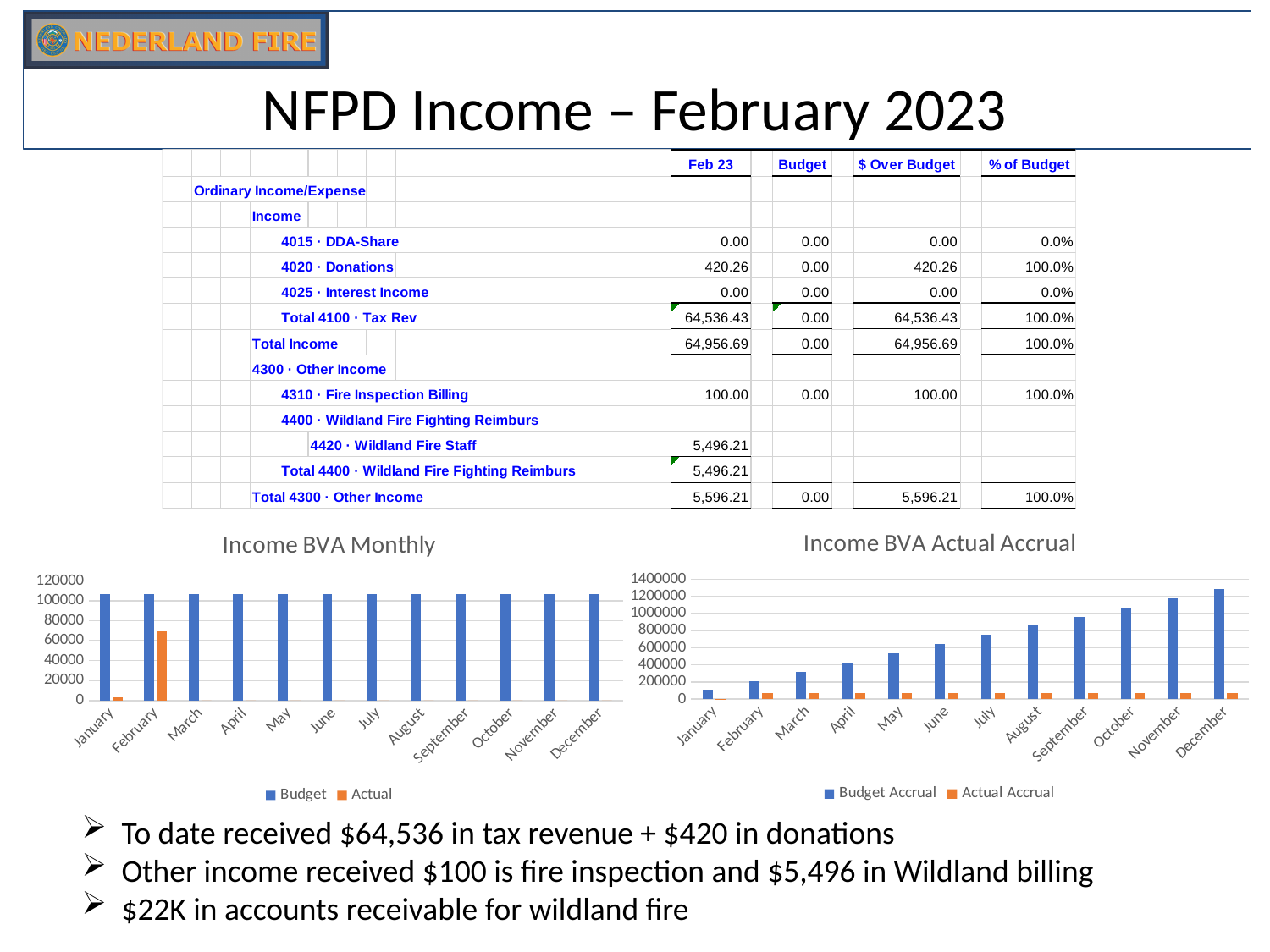
In the 'Income BVA Monthly' chart, which is larger for February, Budget or Actual? Budget In the 'Income BVA Actual Accrual' chart, which month has the highest Budget Accrual value? December In the 'Income BVA Actual Accrual' chart, do the Budget Accrual values rise or fall from January to December? rise How many months are shown on the x axis of the 'Income BVA Actual Accrual' chart? 12 How many series does the legend of the 'Income BVA Monthly' chart list? 2 In the 'Income BVA Actual Accrual' chart, is the Budget Accrual value for December greater or less than 1200000? greater What are the two legend entries of the 'Income BVA Actual Accrual' chart? Budget Accrual and Actual Accrual In the 'Income BVA Actual Accrual' chart, which month has the lowest Budget Accrual value? January What kind of chart is the 'Income BVA Monthly' chart? bar chart In the 'Income BVA Monthly' chart, is the Actual value for February greater or less than 80000? less In the 'Income BVA Monthly' chart, is the Actual value for February greater or less than 60000? greater